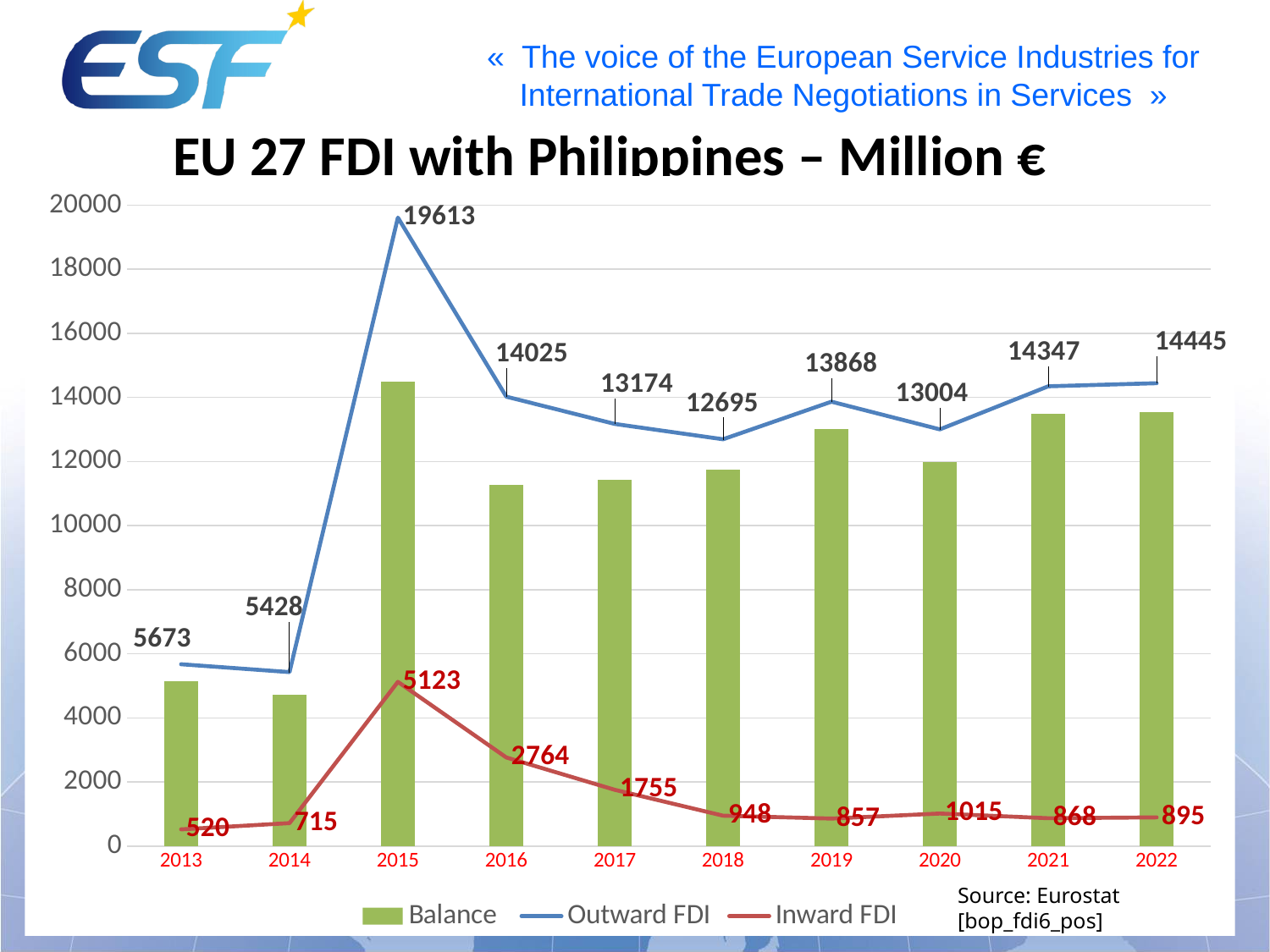
What is the difference between Outward FDI and Inward FDI in 2022? 13550 Is the Balance bar for 2015 greater or less than 14000? greater What is the source cited for the chart data? Eurostat [bop_fdi6_pos] What is the Outward FDI value for 2015? 19613 Which is larger, Outward FDI in 2021 or Outward FDI in 2022? Outward FDI in 2022 How many series does the legend list? 3 Does Inward FDI rise or fall from 2015 to 2019? fall What is the Inward FDI value for 2018? 948 Is the Balance bar for 2013 greater or less than 6000? less How many years are shown on the x axis? 10 In which year is Outward FDI highest? 2015 In which year is Inward FDI lowest? 2013